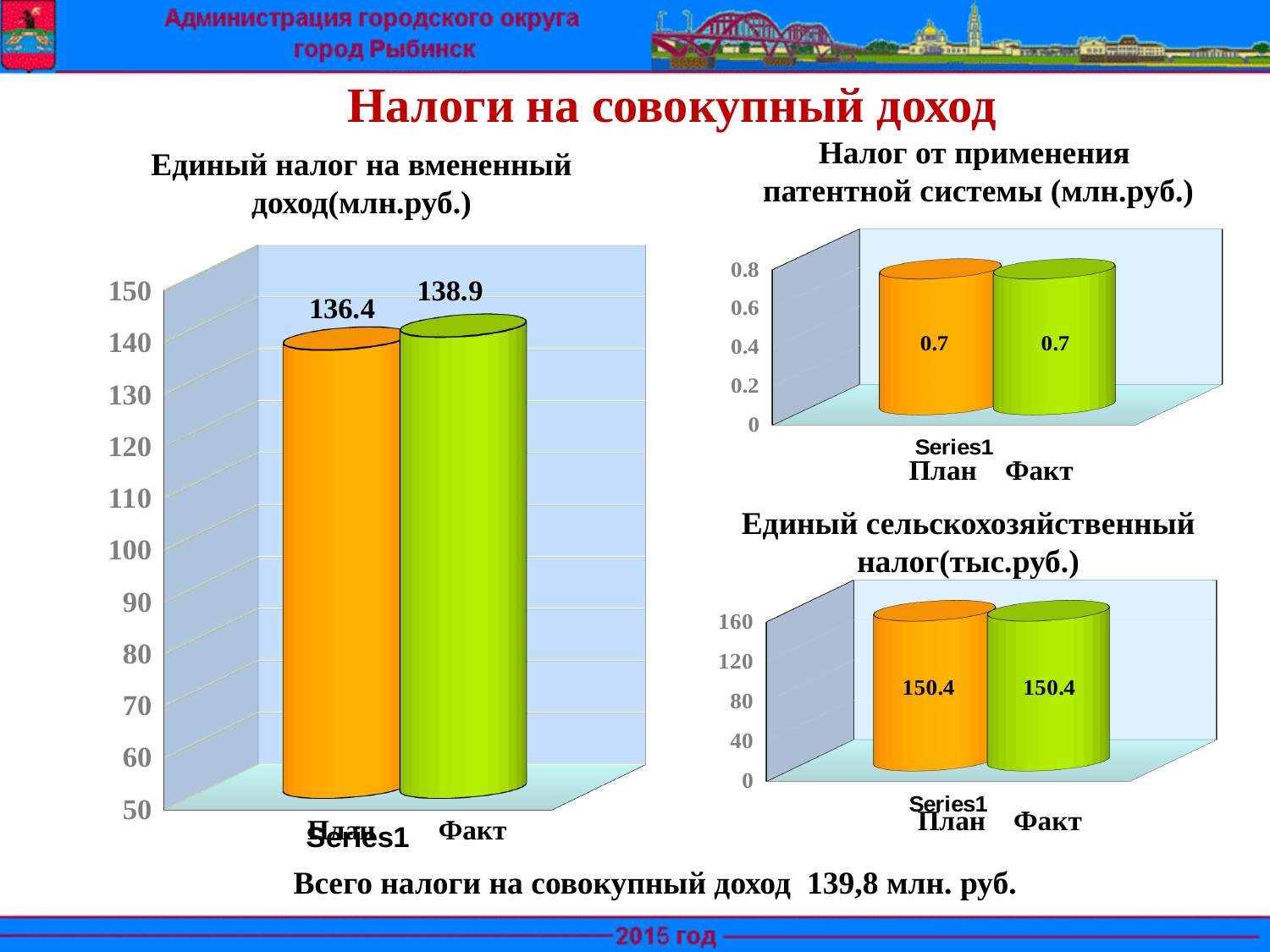
In the chart 'Единый налог на вмененный доход(млн.руб.)', is the value for План greater or less than 100? greater How many charts are shown on the slide? 3 In the chart 'Налог от применения патентной системы (млн.руб.)', what is the value for Факт? 0.7 In the chart 'Налог от применения патентной системы (млн.руб.)', what is the value for План? 0.7 In the chart 'Единый сельскохозяйственный налог(тыс.руб.)', what is the value for Факт? 150.4 In the chart 'Единый налог на вмененный доход(млн.руб.)', which is larger, План or Факт? Факт In the chart 'Единый налог на вмененный доход(млн.руб.)', what is the value for План? 136.4 In the chart 'Единый налог на вмененный доход(млн.руб.)', what is the value for Факт? 138.9 In the chart 'Единый сельскохозяйственный налог(тыс.руб.)', what is the difference between План and Факт? 0 In the chart 'Единый налог на вмененный доход(млн.руб.)', what is the difference between Факт and План? 2.5 How many bars are shown in the chart 'Единый сельскохозяйственный налог(тыс.руб.)'? 2 What kind of chart is 'Единый налог на вмененный доход(млн.руб.)'? bar chart